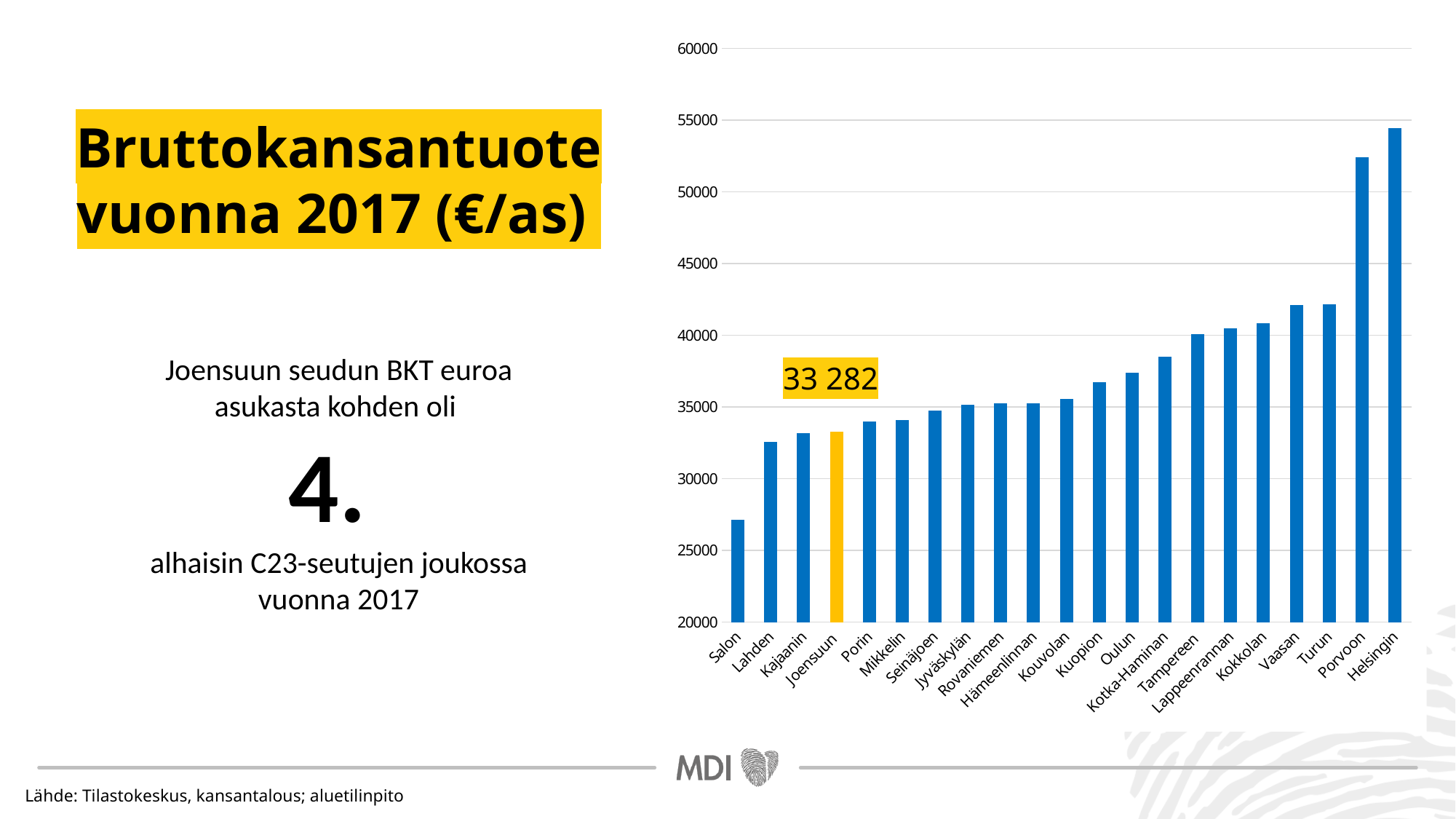
What is the value for Joensuun? 33 282 Do the values rise or fall from left to right along the x axis? rise How many regions are shown on the chart? 21 Which region has the lowest value? Salon Is the value for Helsingin greater or less than 50000? greater Is the value for Salon greater or less than 30000? less Which region has the highest value? Helsingin Which is larger, the value for Lahden or the value for Oulun? Oulun Is the value for Kuopion greater or less than 35000? greater What kind of chart is shown on the slide? bar chart Which is larger, the value for Porvoon or the value for Turun? Porvoon